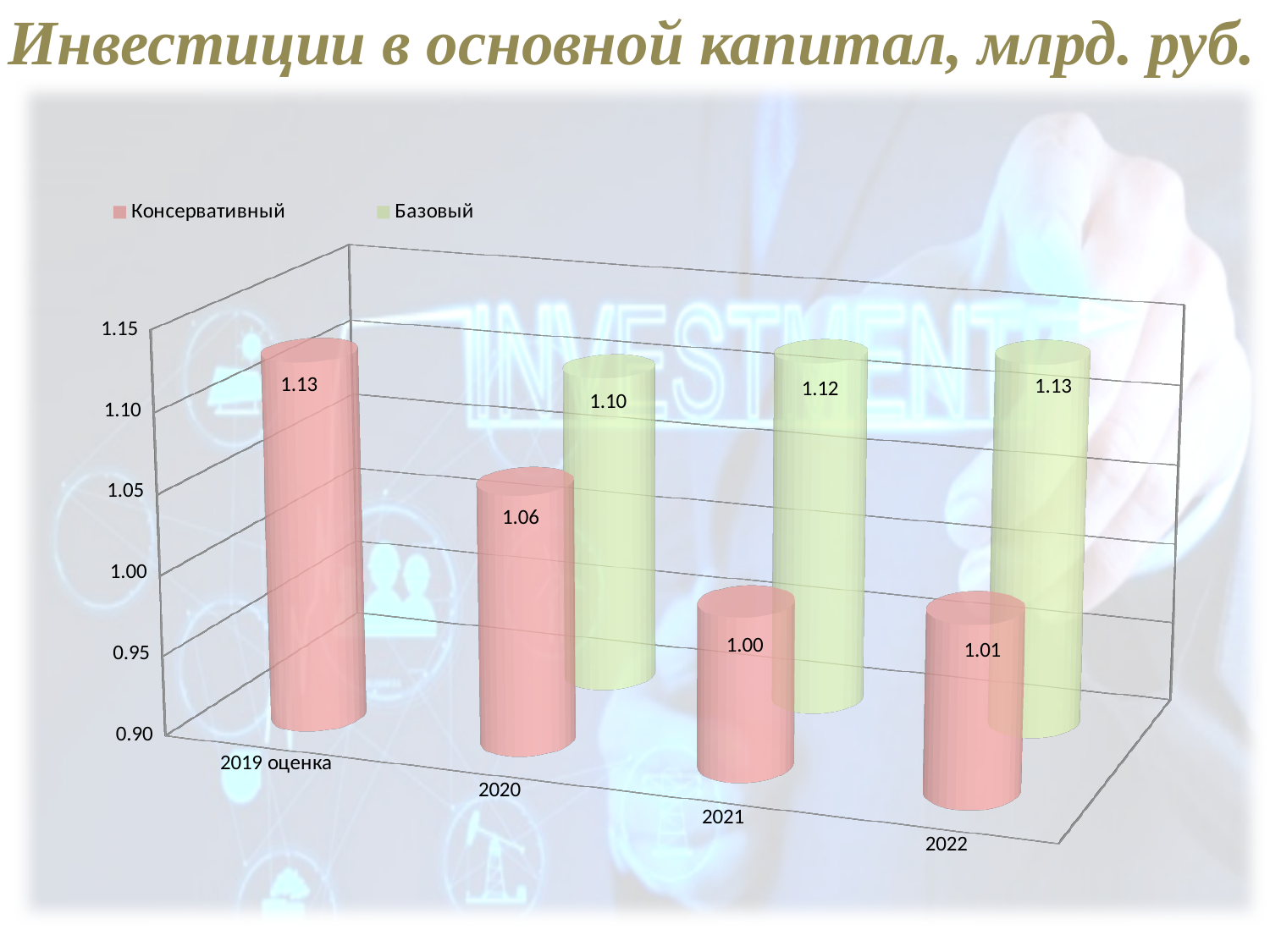
Does the Консервативный series rise or fall from 2019 оценка to 2021? Fall How many categories are shown on the x axis? 4 In which year is the Консервативный series lowest? 2021 What is the value for Консервативный in 2021? 1.00 What is the value for Базовый in 2022? 1.13 Which is larger in 2020: Консервативный or Базовый? Базовый In which year is the Базовый series highest? 2022 What is the difference between the Базовый and Консервативный values in 2022? 0.12 What is the value for Консервативный in 2020? 1.06 How many series does the legend list? 2 What kind of chart is shown on the slide? Bar chart What is the value for Базовый in 2021? 1.12